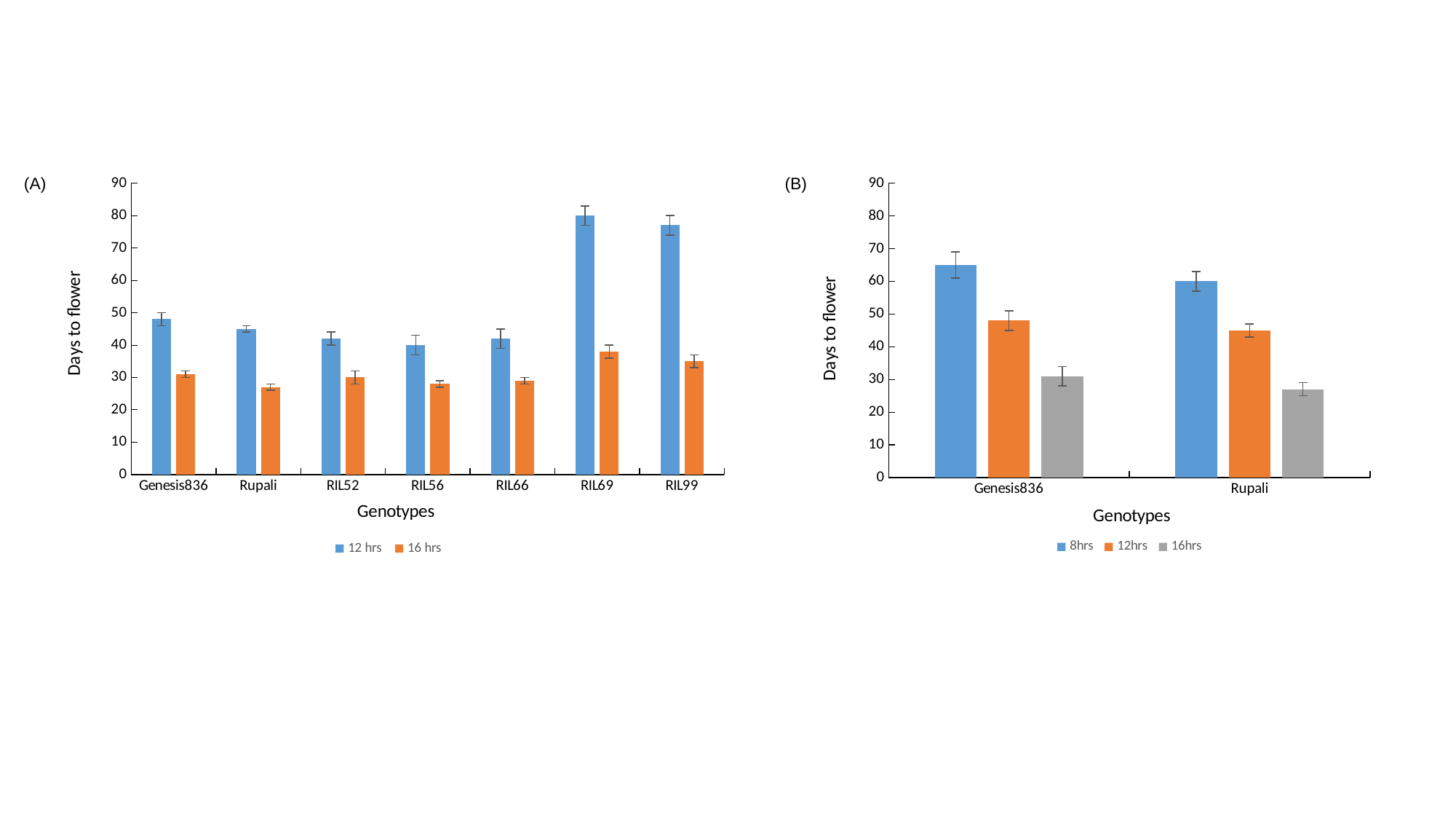
How many series does the legend of chart (B) list? 3 In chart (B), which series has the lowest value for Rupali? 16hrs What kind of chart is chart (A)? bar chart In chart (A), is the 12 hrs value for RIL69 greater or less than 70? greater In chart (A), is the 16 hrs value for Rupali greater or less than 30? less In chart (B), is the 12hrs value for Rupali greater or less than 50? less In chart (A), which is larger for RIL99: the 12 hrs value or the 16 hrs value? 12 hrs How many genotypes are shown on the x axis of chart (A)? 7 How many genotypes are shown on the x axis of chart (B)? 2 How many series does the legend of chart (A) list? 2 What is the y-axis label of chart (B)? Days to flower